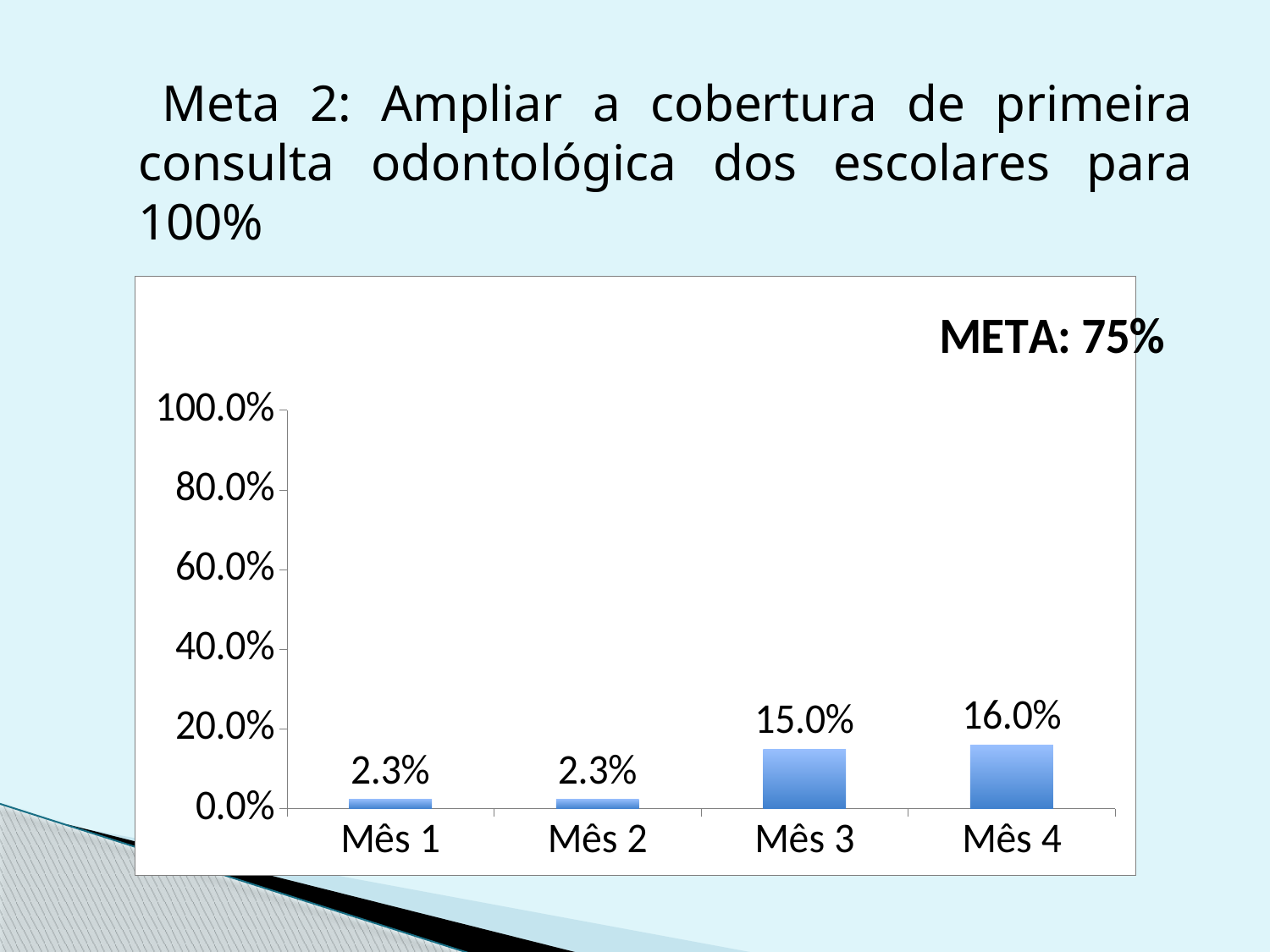
Which is larger, the value for Mês 3 or the value for Mês 1? Mês 3 What kind of chart is shown on the slide? bar chart What is the value for Mês 4? 16.0% Do the values rise or fall from Mês 1 to Mês 4? rise What target (META) is printed on the chart? 75% What is the difference between the values for Mês 3 and Mês 2? 12.7% What is the value for Mês 3? 15.0% What is the value for Mês 1? 2.3% What is the difference between the values for Mês 4 and Mês 3? 1.0% Which month has the highest value? Mês 4 Is the value for Mês 4 greater or less than 20.0%? less How many months are shown on the x axis? 4